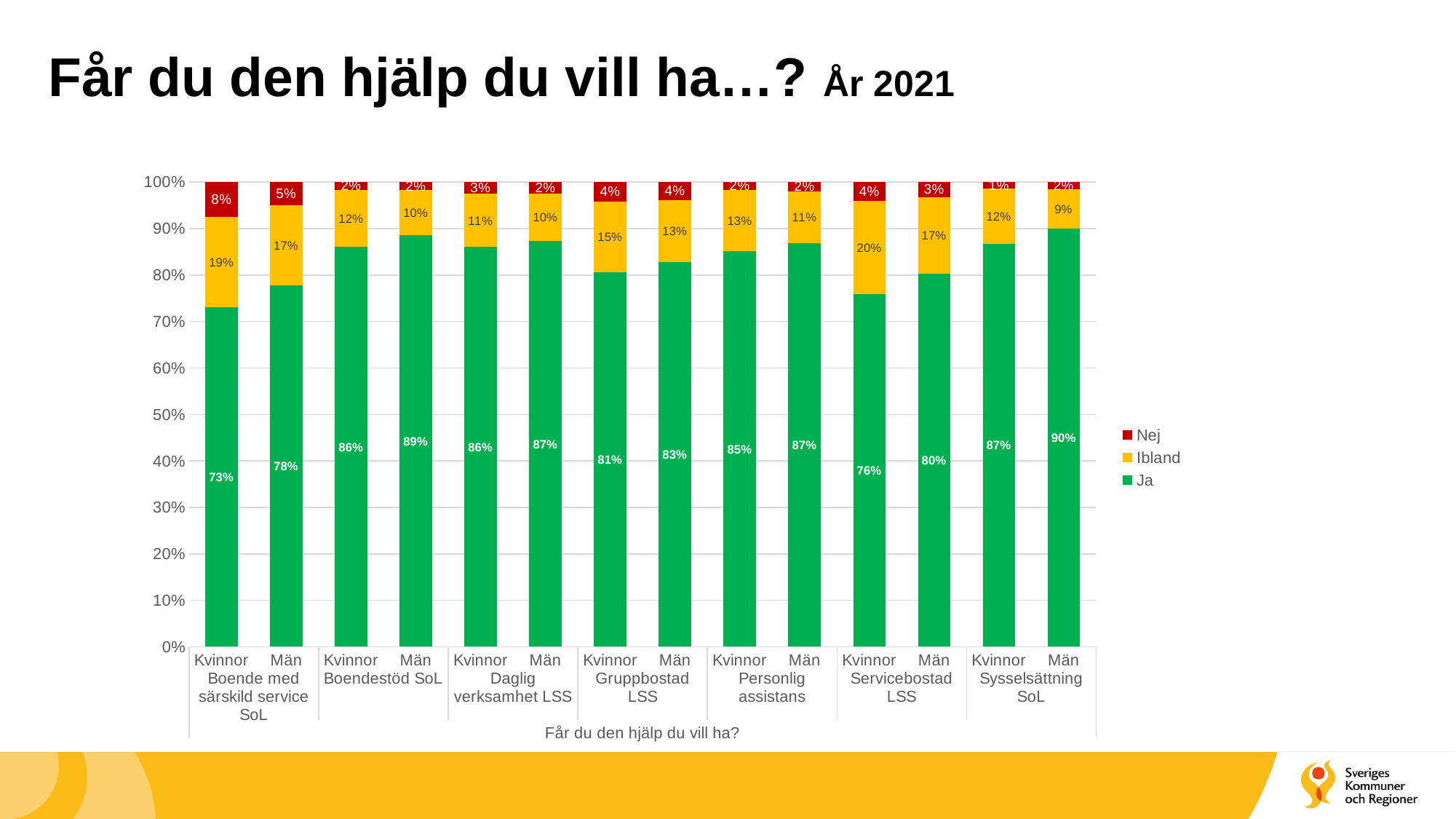
Which group has the highest Nej share? Kvinnor, Boende med särskild service SoL (8%) What is the difference in the Ja share between men and women in Servicebostad LSS? 4 percentage points How many series does the legend list? 3 Who has a higher Ja share in Gruppbostad LSS, women (Kvinnor) or men (Män)? Män What is the Nej share for men (Män) in Boende med särskild service SoL? 5% Which group has the lowest Ja share? Kvinnor, Boende med särskild service SoL (73%) What type of chart is shown on the slide? Stacked bar chart What is the total of the stacked bar for men (Män) in Sysselsättning SoL (Ja + Ibland + Nej)? 101% How many bars are shown in the chart? 14 What percentage of women (Kvinnor) in Boende med särskild service SoL answered Ja? 73% Which group has the highest Ja share? Män, Sysselsättning SoL (90%) What is the Ibland share for women (Kvinnor) in Servicebostad LSS? 20%